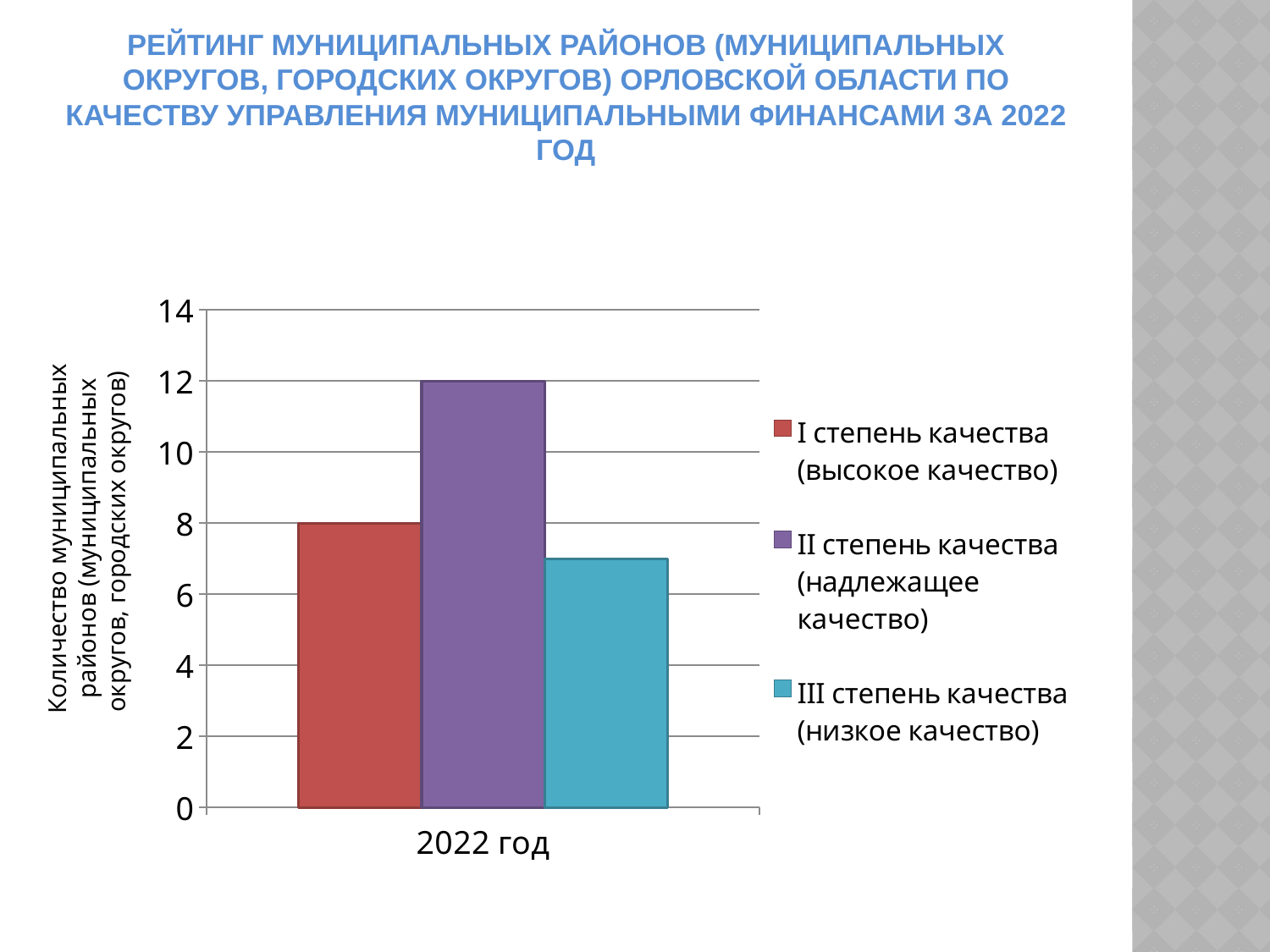
What is the category label shown on the x axis? 2022 год Is the value for III степень качества (низкое качество) greater or less than 8? less How many categories are shown on the x axis? 1 What is the value for I степень качества (высокое качество) in 2022 год? 8 What is the difference between the values for II степень качества and I степень качества? 4 Which series has the lowest value? III степень качества (низкое качество) What kind of chart is shown on the slide? bar chart Is the value for III степень качества (низкое качество) greater or less than 6? greater Which series has the highest value? II степень качества (надлежащее качество) What is the value for II степень качества (надлежащее качество) in 2022 год? 12 How many series does the legend list? 3 Which is larger: the value for I степень качества or the value for II степень качества? II степень качества